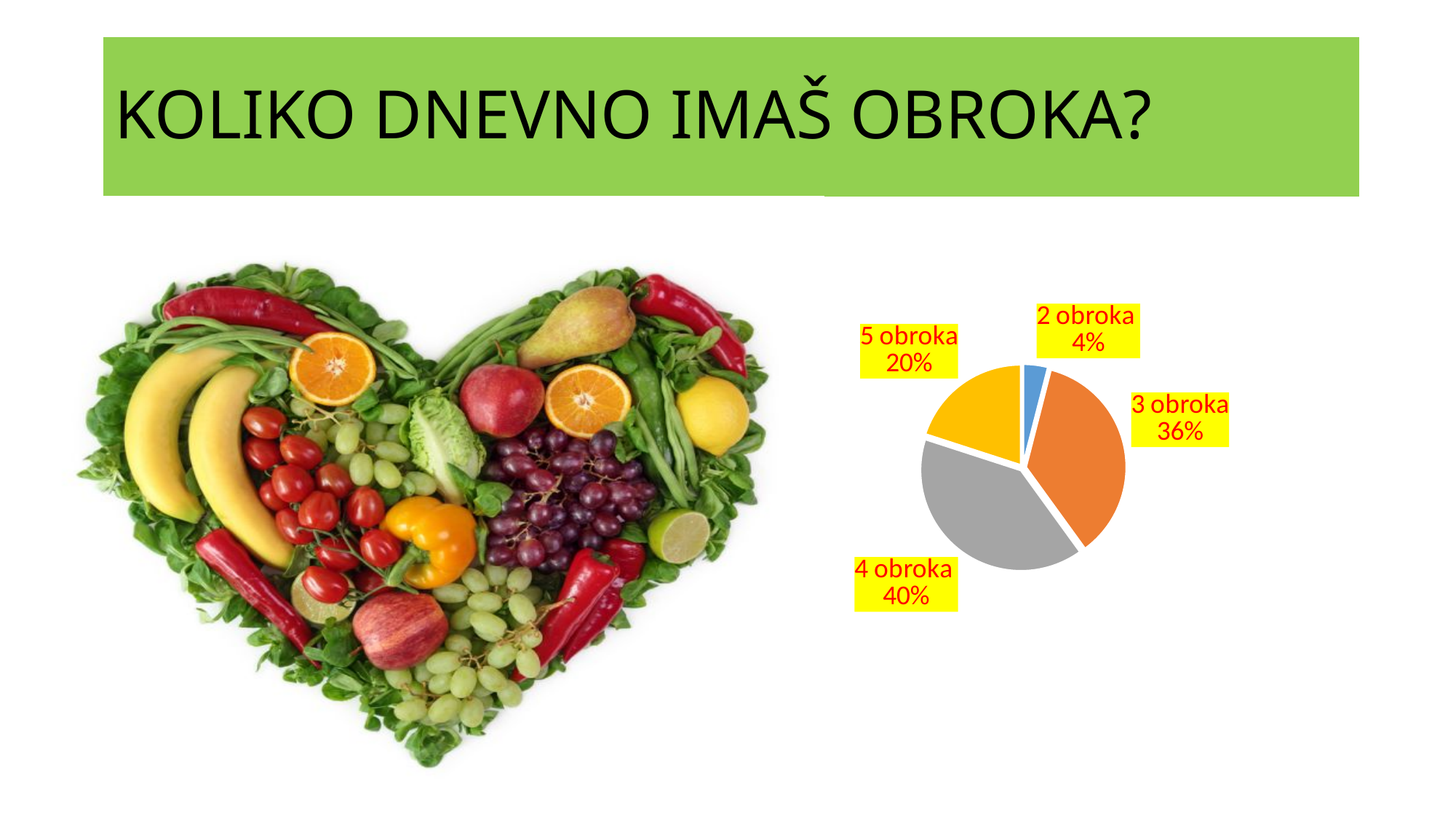
What share of the pie does "2 obroka" have? 4% What share of the pie does "5 obroka" have? 20% What is the title of the slide containing the pie chart? KOLIKO DNEVNO IMAŠ OBROKA? Which category has the smallest slice of the pie? 2 obroka What kind of chart is shown on the slide? pie chart What share of the pie does "4 obroka" have? 40% What is the difference in percentage points between "4 obroka" and "3 obroka"? 4 What is the difference in percentage points between "5 obroka" and "2 obroka"? 16 How many slices does the pie chart have? 4 Which category has the largest slice of the pie? 4 obroka Which is larger, the share for "5 obroka" or the share for "3 obroka"? 3 obroka